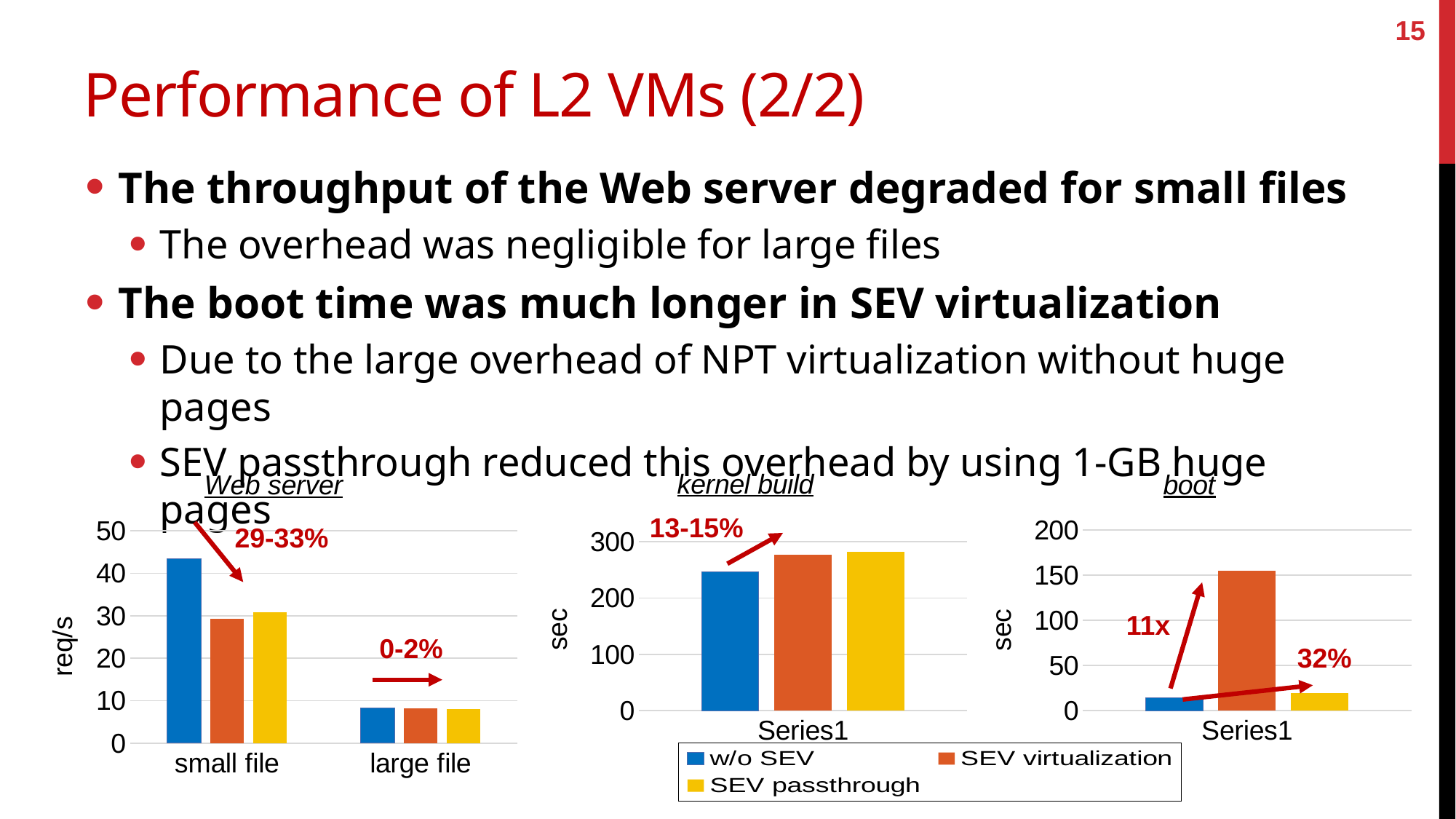
In the boot chart, is the SEV virtualization value greater or less than 150? greater In the Web server chart, is the w/o SEV value for large file greater or less than 10? less In the kernel build chart, which series has the lowest value? w/o SEV In the Web server chart, which series has the highest value for small file? w/o SEV In the Web server chart, is the w/o SEV value for small file greater or less than 40? greater In the boot chart, which series has the highest value? SEV virtualization What is the y-axis label of the Web server chart? req/s How many categories are shown on the x axis of the Web server chart? 2 What type of chart is the Web server chart? bar chart How many series does the legend list? 3